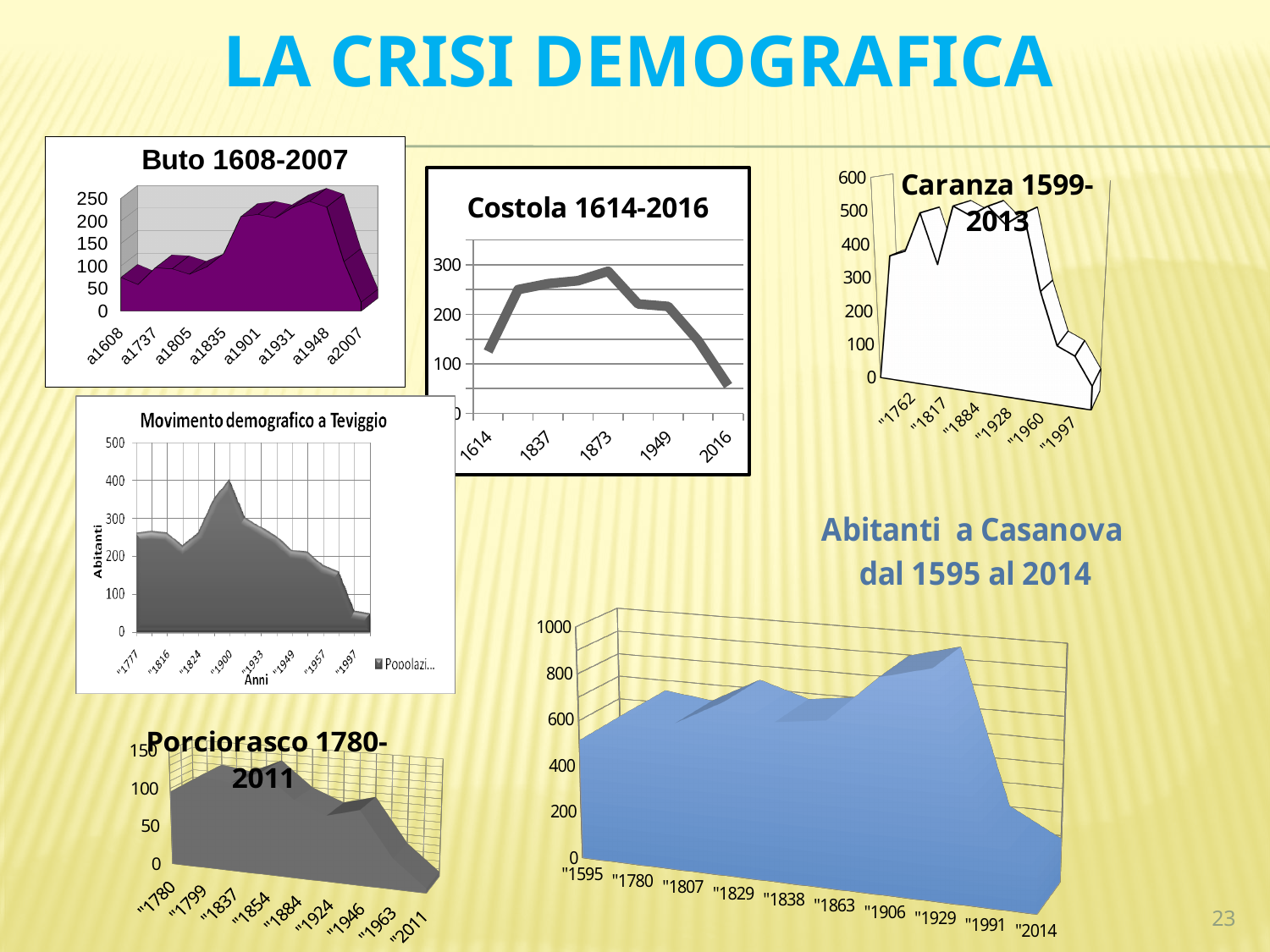
In the 'Porciorasco 1780-2011' chart, how many years are labelled on the x axis? 9 In the 'Movimento demografico a Teviggio' chart, is the value for 1997 greater or less than 100? less In the 'Abitanti a Casanova dal 1595 al 2014' chart, how many years are labelled on the x axis? 10 In the 'Costola 1614-2016' chart, is the value for 2016 greater or less than 100? less In the 'Costola 1614-2016' chart, how many years are labelled on the x axis? 5 In the 'Costola 1614-2016' chart, do the values rise or fall from 1873 to 2016? fall In the 'Costola 1614-2016' chart, is the value for 1873 greater or less than 200? greater What is the y-axis title of the 'Movimento demografico a Teviggio' chart? Abitanti What kind of chart is the 'Abitanti a Casanova dal 1595 al 2014' chart? area chart What kind of chart is the 'Costola 1614-2016' chart? line chart